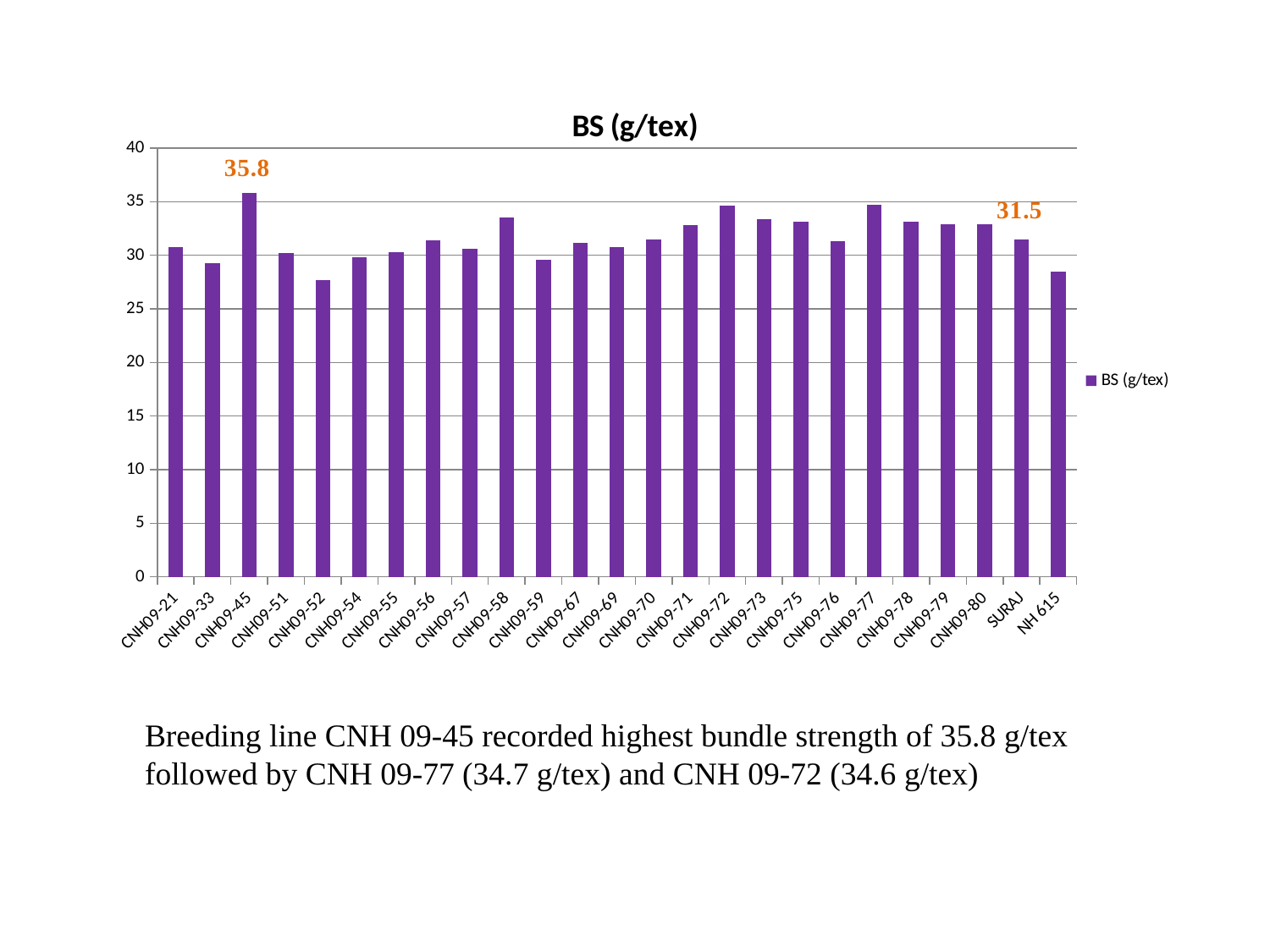
What type of chart is shown on the slide? bar chart Is the BS (g/tex) value for CNH09-58 greater or less than 30? greater How many series does the legend list? 1 How many breeding lines are plotted on the x axis? 25 Which breeding line has the highest BS (g/tex) value? CNH09-45 Which has a larger BS (g/tex) value, CNH09-45 or SURAJ? CNH09-45 What is the BS (g/tex) value for SURAJ? 31.5 What is the difference between the BS (g/tex) values of CNH09-45 and SURAJ? 4.3 What is the title of the chart? BS (g/tex) Is the BS (g/tex) value for NH 615 greater or less than 30? less What is the BS (g/tex) value for CNH09-45? 35.8 Is the BS (g/tex) value for CNH09-52 greater or less than 30? less